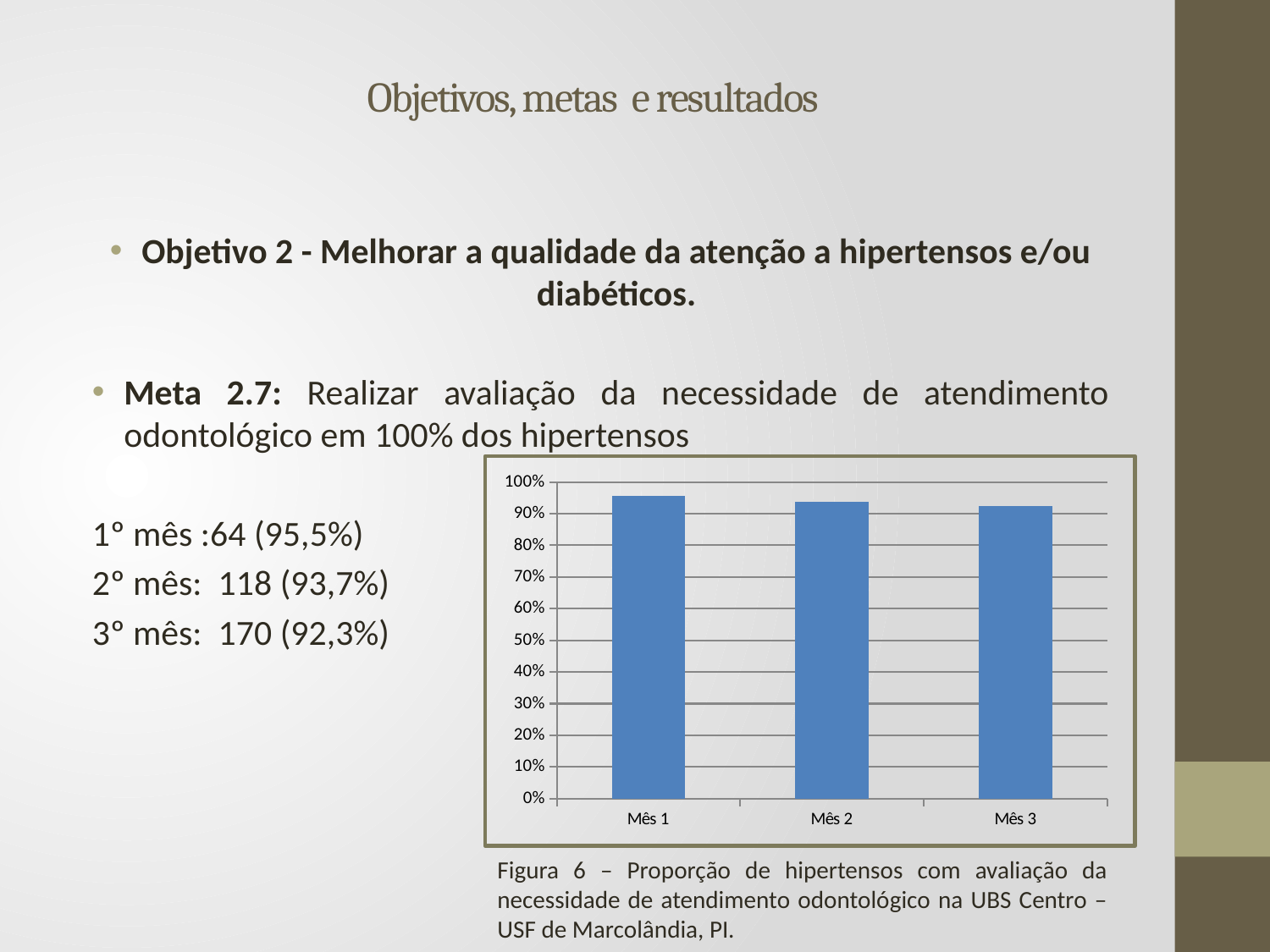
What colour are the bars in the chart? blue Is the value for Mês 2 greater or less than 80%? greater What kind of chart is shown on the slide? bar chart Is the value for Mês 1 greater or less than 90%? greater Is the value for Mês 3 greater or less than 100%? less What is the highest value shown on the y axis of the chart? 100% Which month has the tallest bar in the chart? Mês 1 How many categories (months) are shown on the x axis of the chart? 3 Which month has the shortest bar in the chart? Mês 3 Which is larger, the value for Mês 1 or the value for Mês 3? Mês 1 Do the values rise or fall from Mês 1 to Mês 3? fall